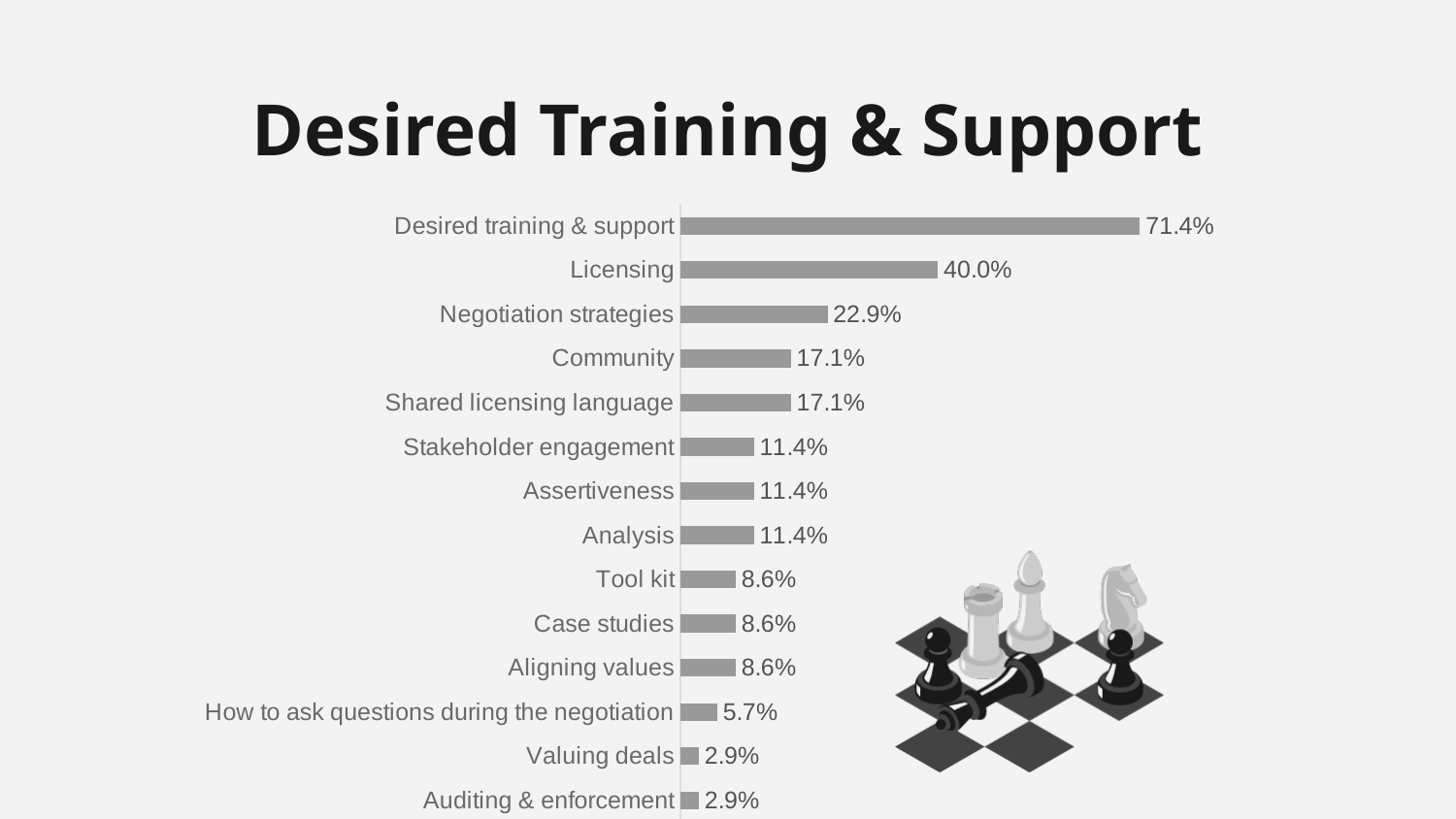
What is the value for Auditing & enforcement? 2.9% Which is larger, the value for Community or the value for Tool kit? Community What kind of chart is shown on the slide? Bar chart What is the difference between the values for Licensing and Negotiation strategies? 17.1% Which category has the highest value? Desired training & support How many categories are shown in the chart? 14 What is the difference between the values for Desired training & support and Licensing? 31.4% What is the value for Licensing? 40.0% What is the value for How to ask questions during the negotiation? 5.7% What is the title of the slide? Desired Training & Support What is the value for Stakeholder engagement? 11.4% What is the value for Negotiation strategies? 22.9%